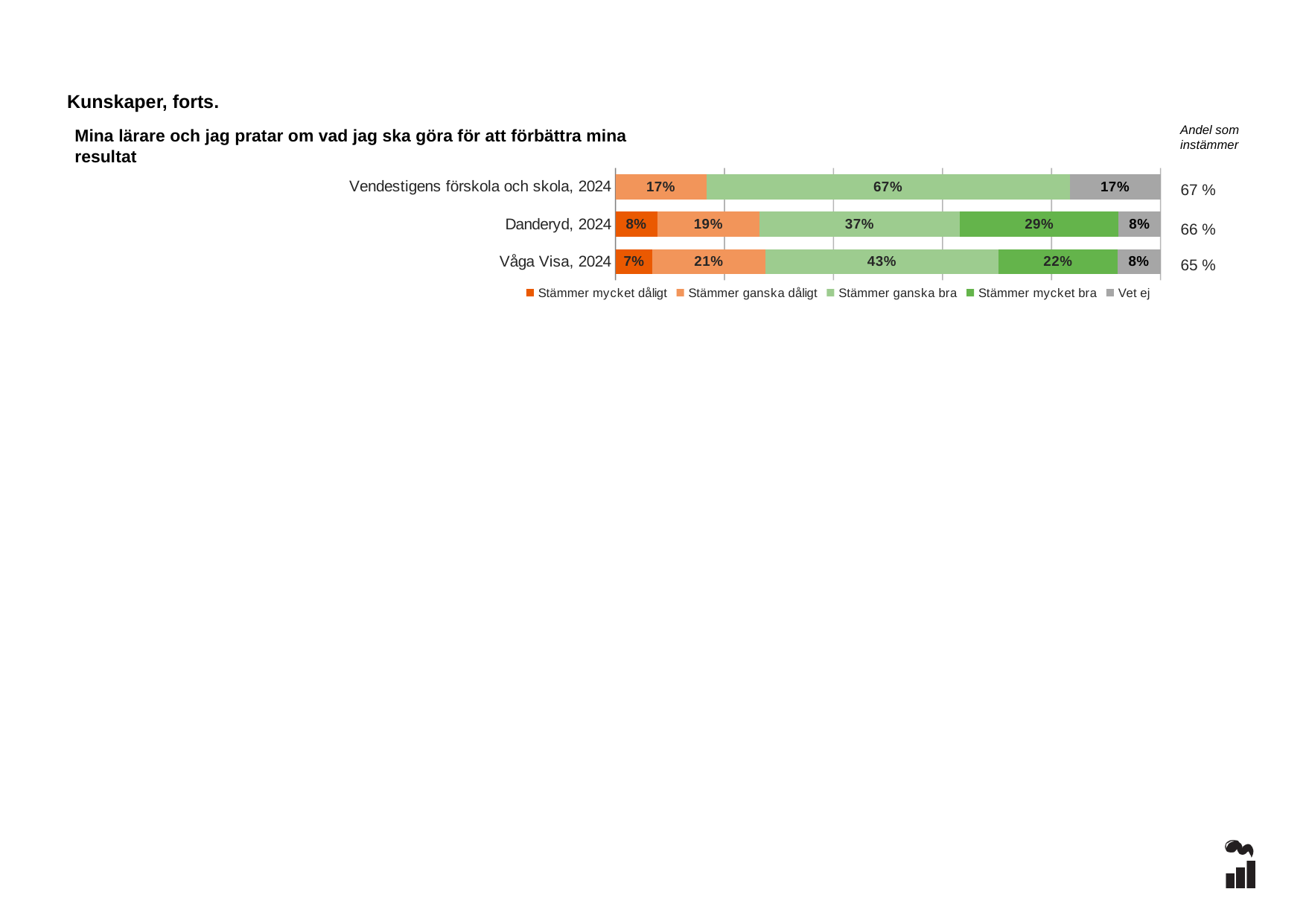
How many series does the legend list? 5 What kind of chart is shown on the slide? Stacked bar chart What is the "Vet ej" value for Vendestigens förskola och skola, 2024? 17% Which is larger: the "Stämmer mycket bra" value for Danderyd, 2024 or for Våga Visa, 2024? Danderyd, 2024 Which category has the lowest "Andel som instämmer" figure? Våga Visa, 2024 What is the "Andel som instämmer" figure shown for Danderyd, 2024? 66 % What is the "Stämmer mycket dåligt" value for Våga Visa, 2024? 7% How many categories (bars) are shown in the chart? 3 Which category has the highest "Stämmer ganska bra" value? Vendestigens förskola och skola, 2024 What is the difference between the "Stämmer ganska bra" values for Våga Visa, 2024 and Danderyd, 2024? 6% What percentage of respondents at Vendestigens förskola och skola, 2024 answered "Stämmer ganska bra"? 67% What is the "Stämmer mycket bra" value for Danderyd, 2024? 29%